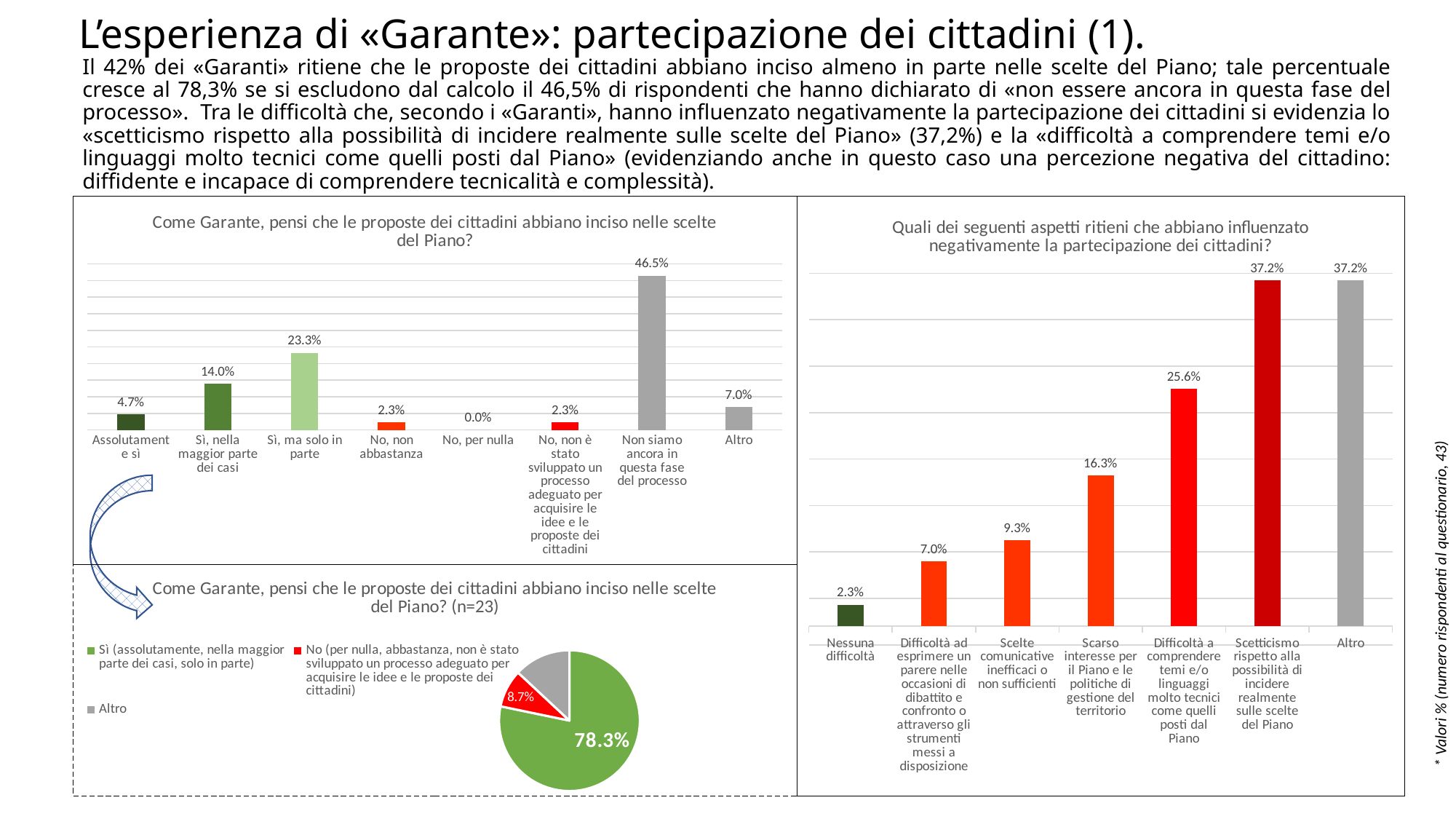
In the top-left chart 'Come Garante, pensi che le proposte dei cittadini abbiano inciso nelle scelte del Piano?', which category has the highest value? Non siamo ancora in questa fase del processo In the pie chart 'Come Garante, pensi che le proposte dei cittadini abbiano inciso nelle scelte del Piano? (n=23)', what share is labelled for the 'Sì' slice? 78.3% In the right chart 'Quali dei seguenti aspetti ritieni che abbiano influenzato negativamente la partecipazione dei cittadini?', what is the value for 'Difficoltà a comprendere temi e/o linguaggi molto tecnici come quelli posti dal Piano'? 25.6% In the pie chart 'Come Garante, pensi che le proposte dei cittadini abbiano inciso nelle scelte del Piano? (n=23)', what is the value of the red 'No' slice? 8.7% In the top-left chart 'Come Garante, pensi che le proposte dei cittadini abbiano inciso nelle scelte del Piano?', what is the difference between 'Sì, ma solo in parte' and 'Sì, nella maggior parte dei casi'? 9.3% In the right chart 'Quali dei seguenti aspetti ritieni che abbiano influenzato negativamente la partecipazione dei cittadini?', which category has the lowest value? Nessuna difficoltà In the top-left chart 'Come Garante, pensi che le proposte dei cittadini abbiano inciso nelle scelte del Piano?', what is the value for 'Non siamo ancora in questa fase del processo'? 46.5% What type of chart is the bottom-left chart with the title ending in '(n=23)'? Pie chart How many categories are shown in the right chart 'Quali dei seguenti aspetti ritieni che abbiano influenzato negativamente la partecipazione dei cittadini?'? 7 In the top-left chart 'Come Garante, pensi che le proposte dei cittadini abbiano inciso nelle scelte del Piano?', which category has the lowest value? No, per nulla How many categories are shown in the top-left chart 'Come Garante, pensi che le proposte dei cittadini abbiano inciso nelle scelte del Piano?'? 8 In the right chart 'Quali dei seguenti aspetti ritieni che abbiano influenzato negativamente la partecipazione dei cittadini?', which is larger: 'Scarso interesse per il Piano e le politiche di gestione del territorio' or 'Scelte comunicative inefficaci o non sufficienti'? Scarso interesse per il Piano e le politiche di gestione del territorio